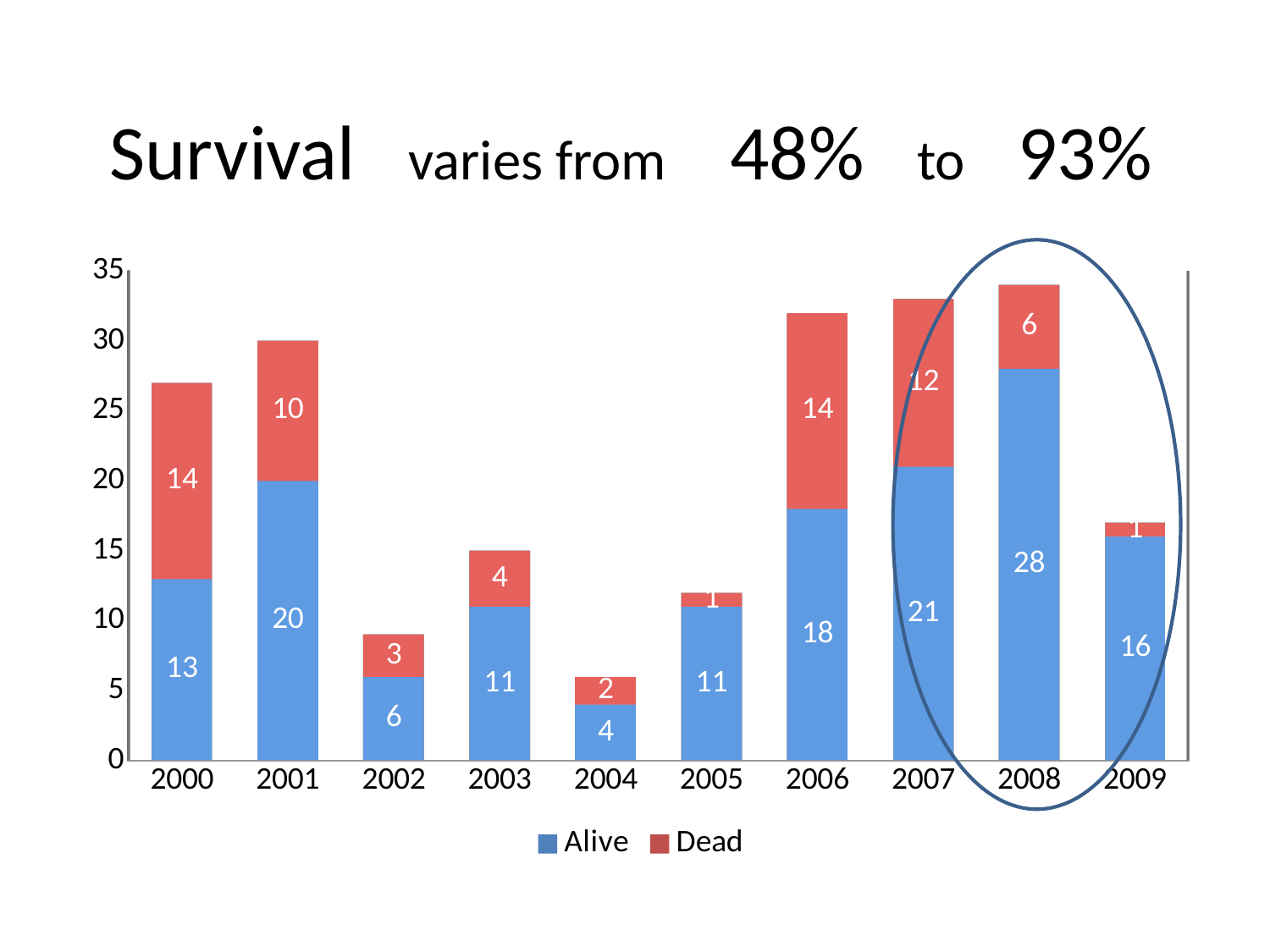
What is the Alive value for 2008? 28 Which is larger, the Dead value for 2000 or the Dead value for 2007? 2000 What is the difference between the Alive values for 2001 and 2002? 14 What is the total of the stacked bar for 2007? 33 How many series does the legend list? 2 What is the Alive value for 2004? 4 What is the Dead value for 2006? 14 What kind of chart is shown on the slide? Stacked bar chart How many years are shown on the x axis? 10 What is the total of the stacked bar for 2002? 9 Which year has the highest Alive value? 2008 Which year has the lowest Alive value? 2004